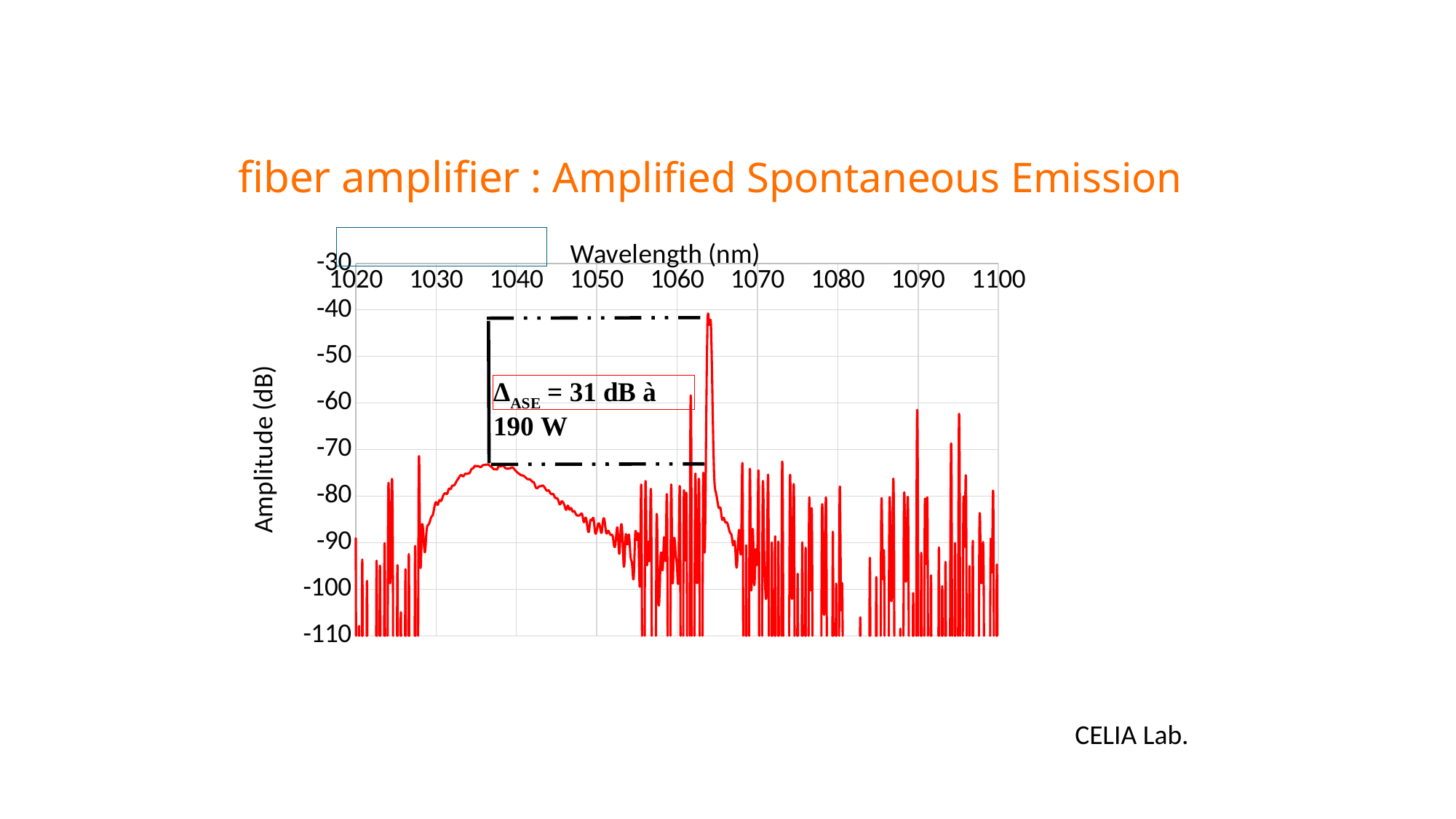
What is the lowest amplitude tick shown on the y axis? -110 Between which two x-axis ticks does the tallest peak of the spectrum lie? 1060 and 1070 What is the highest amplitude tick shown on the y axis? -30 Is the amplitude of the broad hump around 1035 nm greater or less than -60 dB? less Is the amplitude of the tallest peak greater or less than -50 dB? greater What is the title of the x axis of the chart? Wavelength (nm) What value of Δ_ASE is printed in the annotation on the chart? 31 dB What is the title of the y axis of the chart? Amplitude (dB) What is the highest wavelength tick shown on the x axis? 1100 At what power is the Δ_ASE value in the annotation given? 190 W What kind of chart is shown on the slide? line chart What is the lowest wavelength tick shown on the x axis? 1020